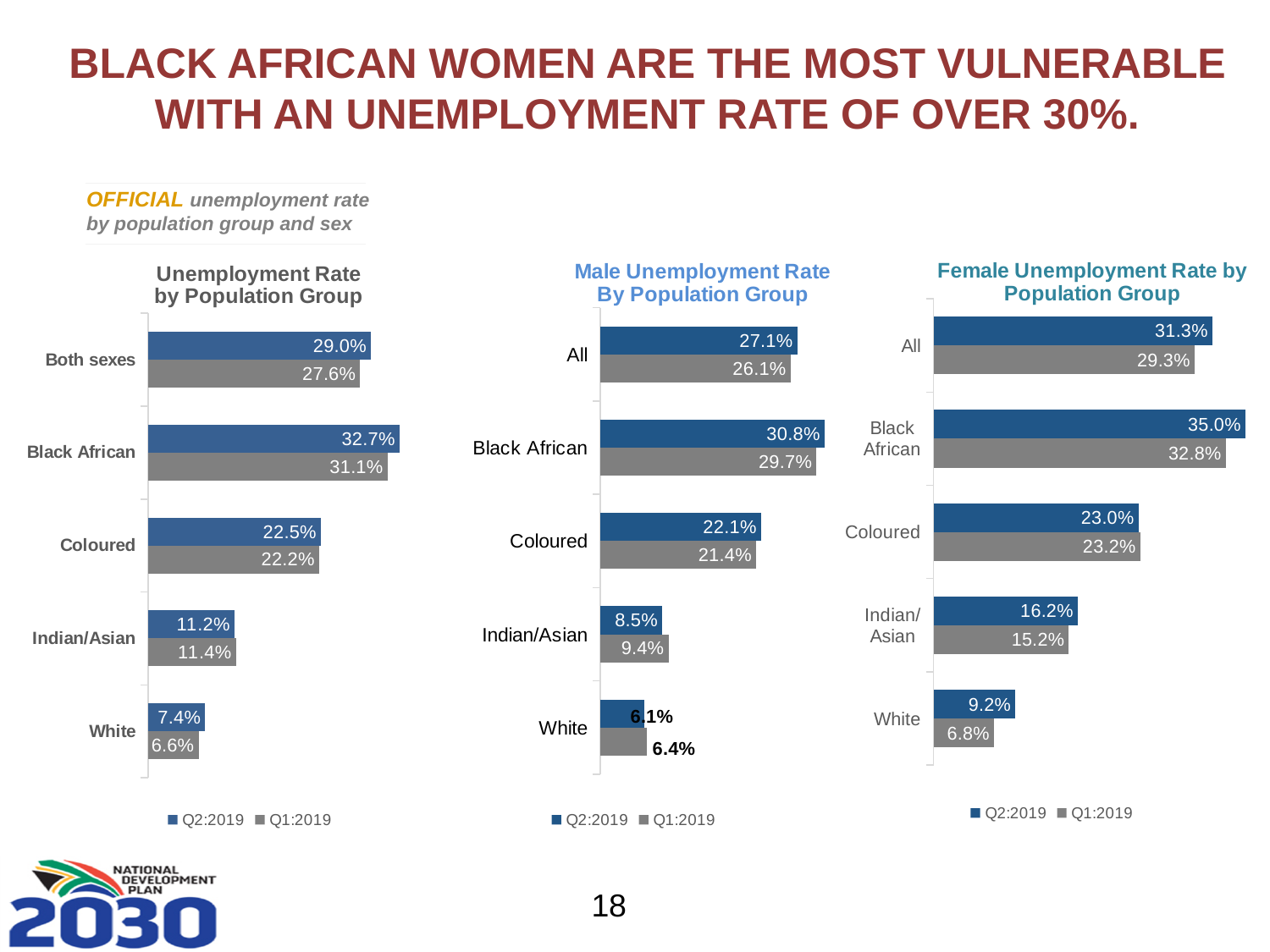
How many series does the legend of the 'Female Unemployment Rate by Population Group' chart list? 2 What are the two legend entries in the 'Unemployment Rate by Population Group' chart? Q2:2019 and Q1:2019 In the 'Female Unemployment Rate by Population Group' chart, which population group has the lowest Q2:2019 value? White What type of chart is the 'Unemployment Rate by Population Group' chart? Bar chart In the 'Male Unemployment Rate By Population Group' chart, which population group has the highest Q2:2019 value? Black African How many population group categories are shown in the 'Male Unemployment Rate By Population Group' chart? 5 In the 'Female Unemployment Rate by Population Group' chart, which is larger for Coloured: the Q2:2019 value or the Q1:2019 value? Q1:2019 In the 'Male Unemployment Rate By Population Group' chart, what is the Q1:2019 value for Coloured? 21.4% In the 'Unemployment Rate by Population Group' chart, what is the Q2:2019 value for Black African? 32.7% In the 'Female Unemployment Rate by Population Group' chart, what is the Q2:2019 value for Black African? 35.0% In the 'Male Unemployment Rate By Population Group' chart, what is the Q2:2019 value for Indian/Asian? 8.5% In the 'Unemployment Rate by Population Group' chart, what is the difference between the Q2:2019 and Q1:2019 values for Both sexes? 1.4%